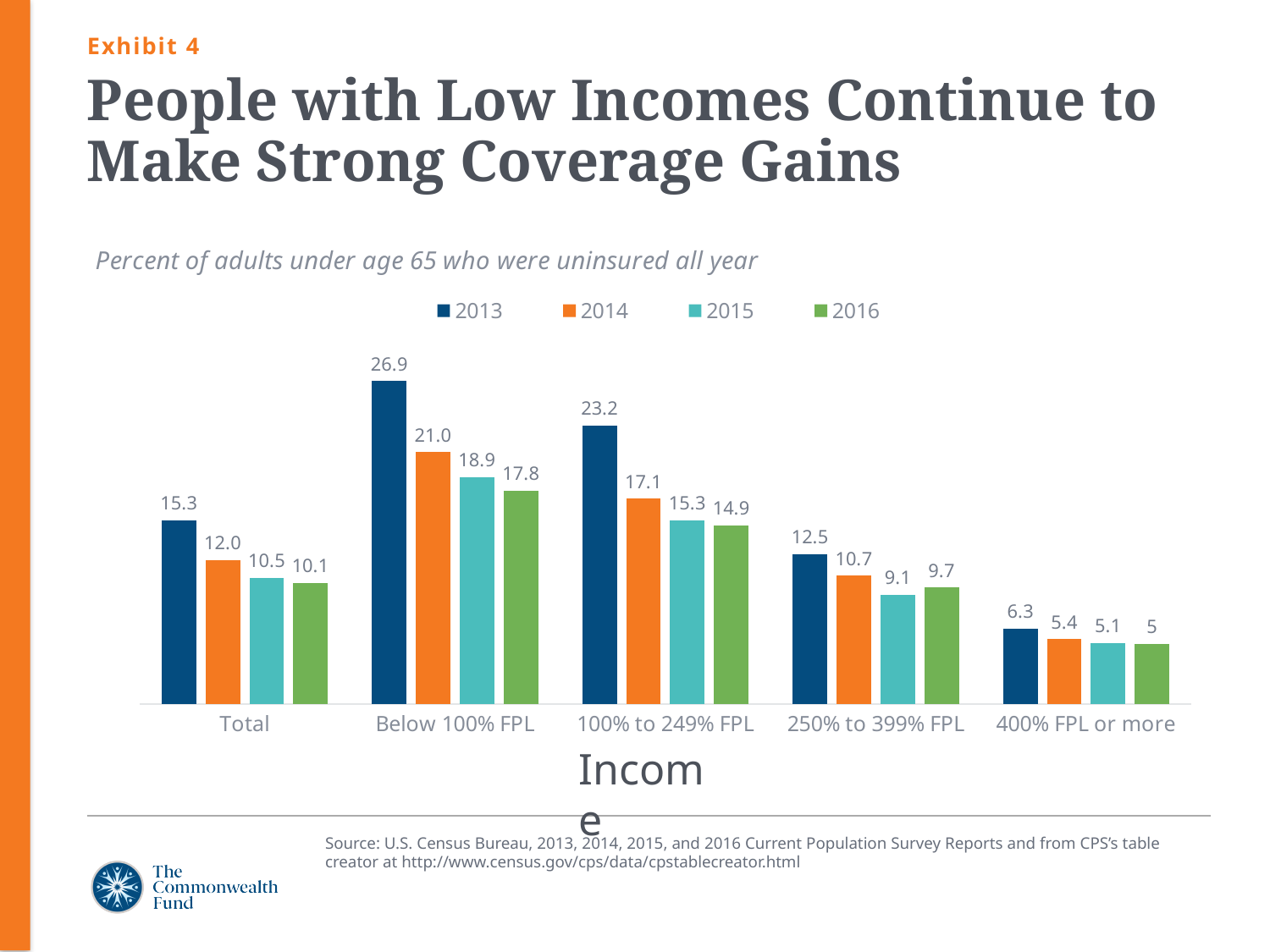
What was the percent of adults under age 65 uninsured all year for Below 100% FPL in 2013? 26.9 Which income category had the highest uninsured rate in 2013? Below 100% FPL By how much did the uninsured rate for Below 100% FPL fall from 2013 to 2016? 9.1 How many series does the legend list? 4 What is the difference between the 2013 and 2014 values for 100% to 249% FPL? 6.1 Which income category had the lowest uninsured rate in 2016? 400% FPL or more What kind of chart is shown on the slide? Bar chart What was the value for 250% to 399% FPL in 2015? 9.1 How many income categories are shown on the x axis? 5 Which is larger: the 2015 value for 250% to 399% FPL or the 2016 value for 250% to 399% FPL? 2016 value (9.7) What was the value for the Total category in 2016? 10.1 What was the value for 400% FPL or more in 2014? 5.4